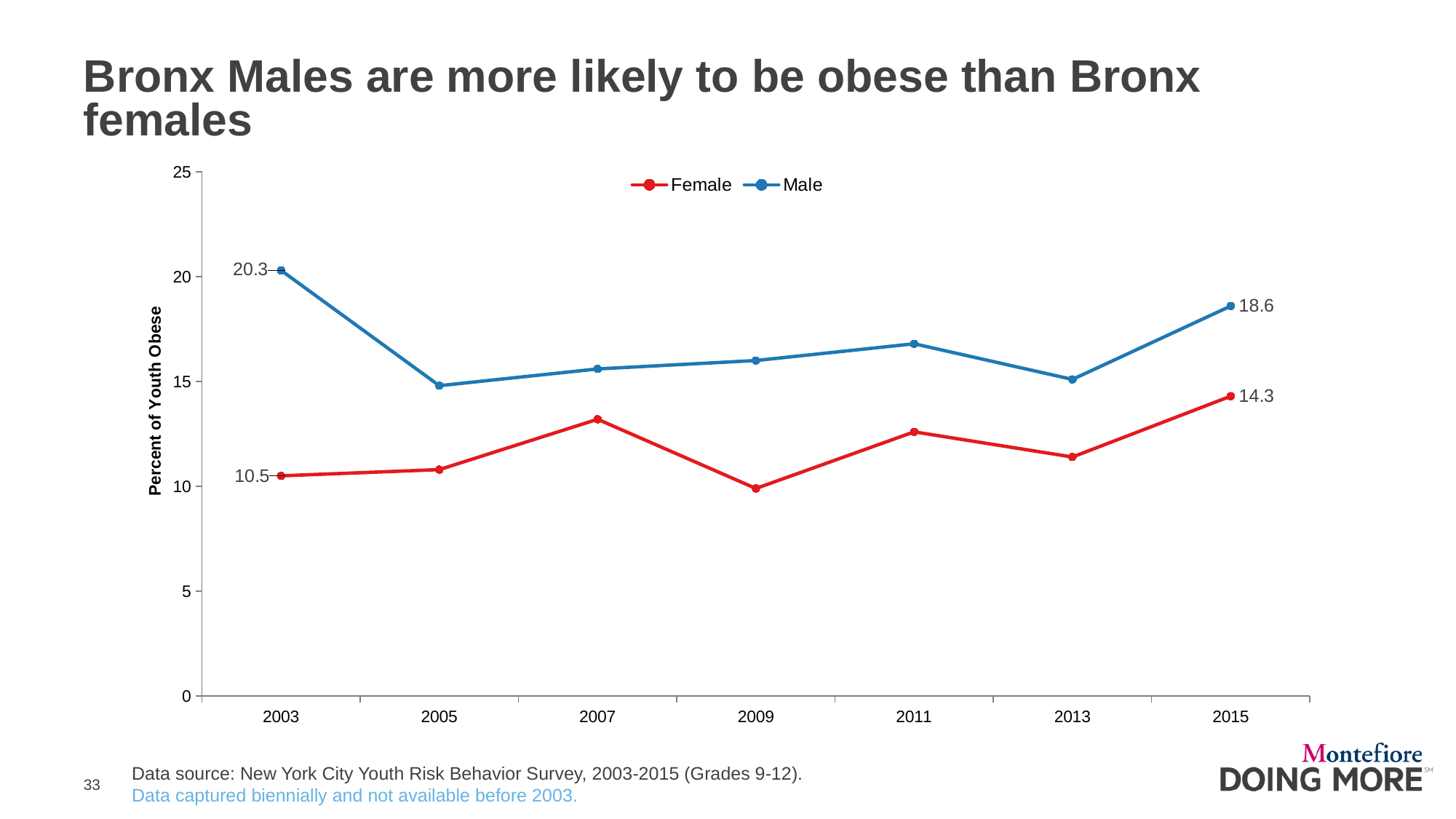
What is the value for Female in 2015? 14.3 What kind of chart is shown on the slide? line chart What is the value for Male in 2003? 20.3 How many series does the legend list? 2 What is the value for Female in 2003? 10.5 What is the difference between the Male and Female values in 2015? 4.3 What is the value for Male in 2015? 18.6 By how much did the Male value decrease from 2003 to 2015? 1.7 How many years are plotted on the x axis? 7 In which year is the Male series at its highest? 2003 In which year is the Female series at its lowest? 2009